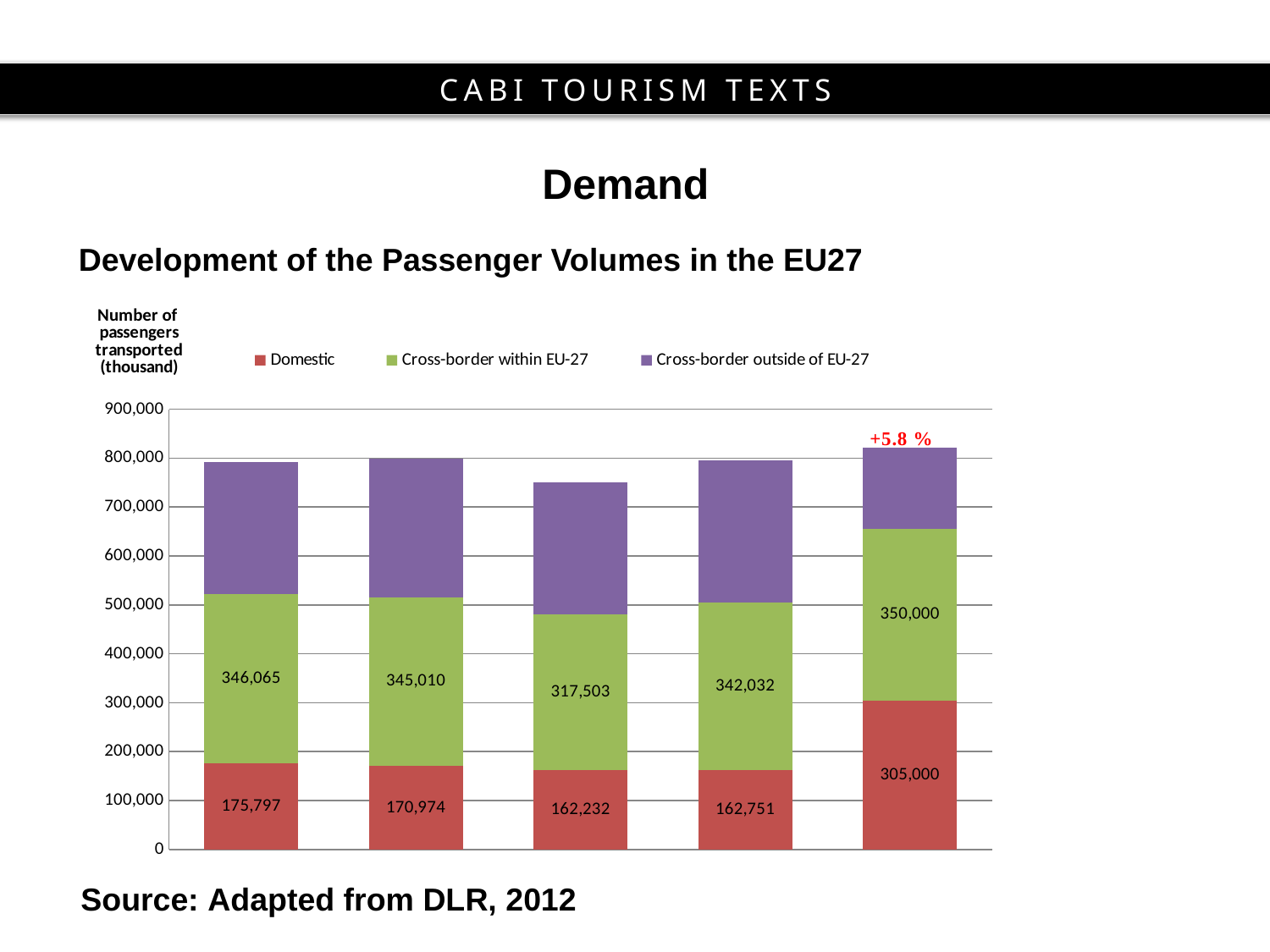
What is the difference between the Domestic values of the first bar and the second bar? 4,823 What is the Domestic value for the first (leftmost) bar? 175,797 What kind of chart is shown on the slide? stacked bar chart What percentage change annotation is printed above the rightmost bar? +5.8 % Which bar has the lowest Domestic value? the third bar, 162,232 How many stacked bars are plotted in the chart? 5 How many series does the legend list? 3 Which bar has the highest Cross-border within EU-27 value? the fifth (rightmost) bar, 350,000 Which is larger: the Cross-border within EU-27 value of the first bar or of the fourth bar? the first bar (346,065) What is the Domestic value for the fifth (rightmost) bar? 305,000 Is the total height of the fifth (rightmost) bar greater or less than 800,000? greater What is the Cross-border within EU-27 value for the third bar? 317,503